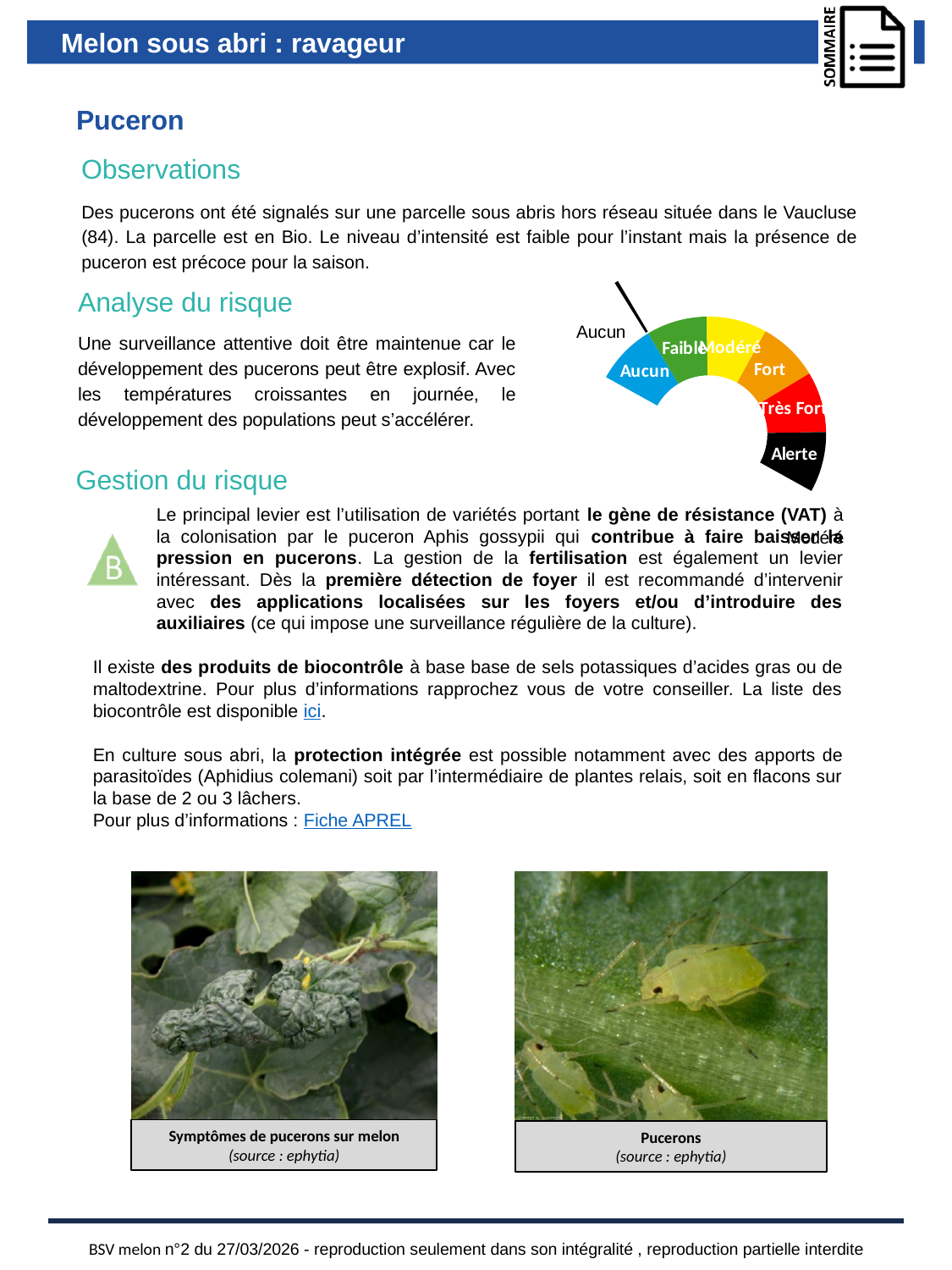
Which segment of the gauge chart is coloured black? Alerte What is the label of the first segment of the gauge chart, at the left end? Aucun What is the label of the last segment of the gauge chart, at the bottom end? Alerte How many risk-level segments does the gauge chart show? 6 Which segment lies between 'Faible' and 'Fort' on the gauge chart? Modéré Which segment comes immediately after 'Fort' on the gauge chart? Très Fort What colour is the 'Faible' segment of the gauge chart? Green Which risk level does the needle of the gauge chart point to? Aucun